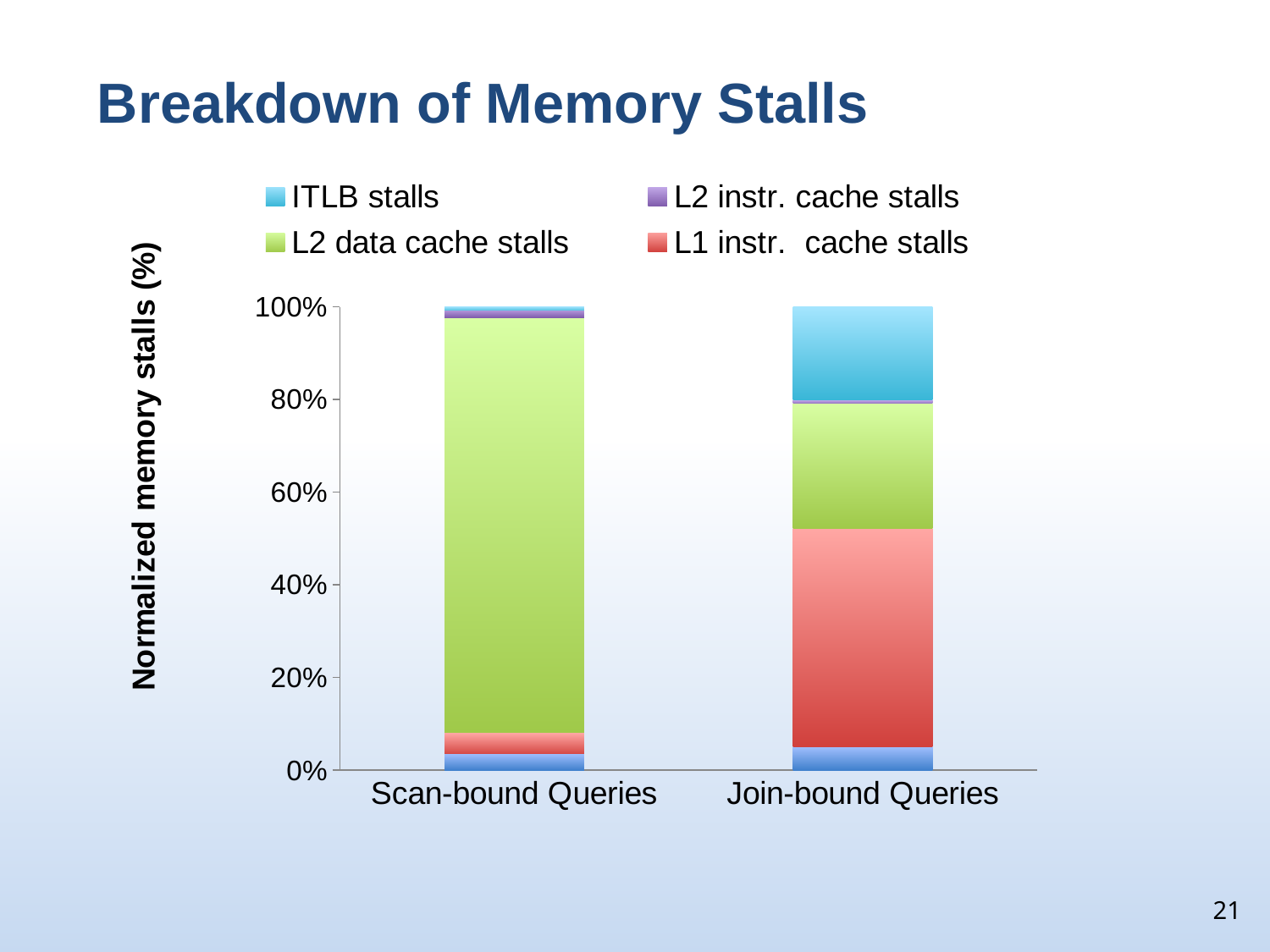
How many categories are shown on the x axis? 2 How many series does the legend list? 4 What is the title of the chart? Breakdown of Memory Stalls Is the L2 data cache stalls value for Scan-bound Queries greater or less than 80%? greater Is the L1 instr. cache stalls value for Join-bound Queries greater or less than 40%? greater Which category has the larger L2 data cache stalls value, Scan-bound Queries or Join-bound Queries? Scan-bound Queries Is the ITLB stalls value for Join-bound Queries greater or less than 40%? less Which series makes up the largest share of the Scan-bound Queries bar? L2 data cache stalls What kind of chart is shown on the slide? stacked bar chart Which legend series makes up the largest share of the Join-bound Queries bar? L1 instr. cache stalls What is the label of the vertical axis? Normalized memory stalls (%) Which category has the larger ITLB stalls value, Scan-bound Queries or Join-bound Queries? Join-bound Queries